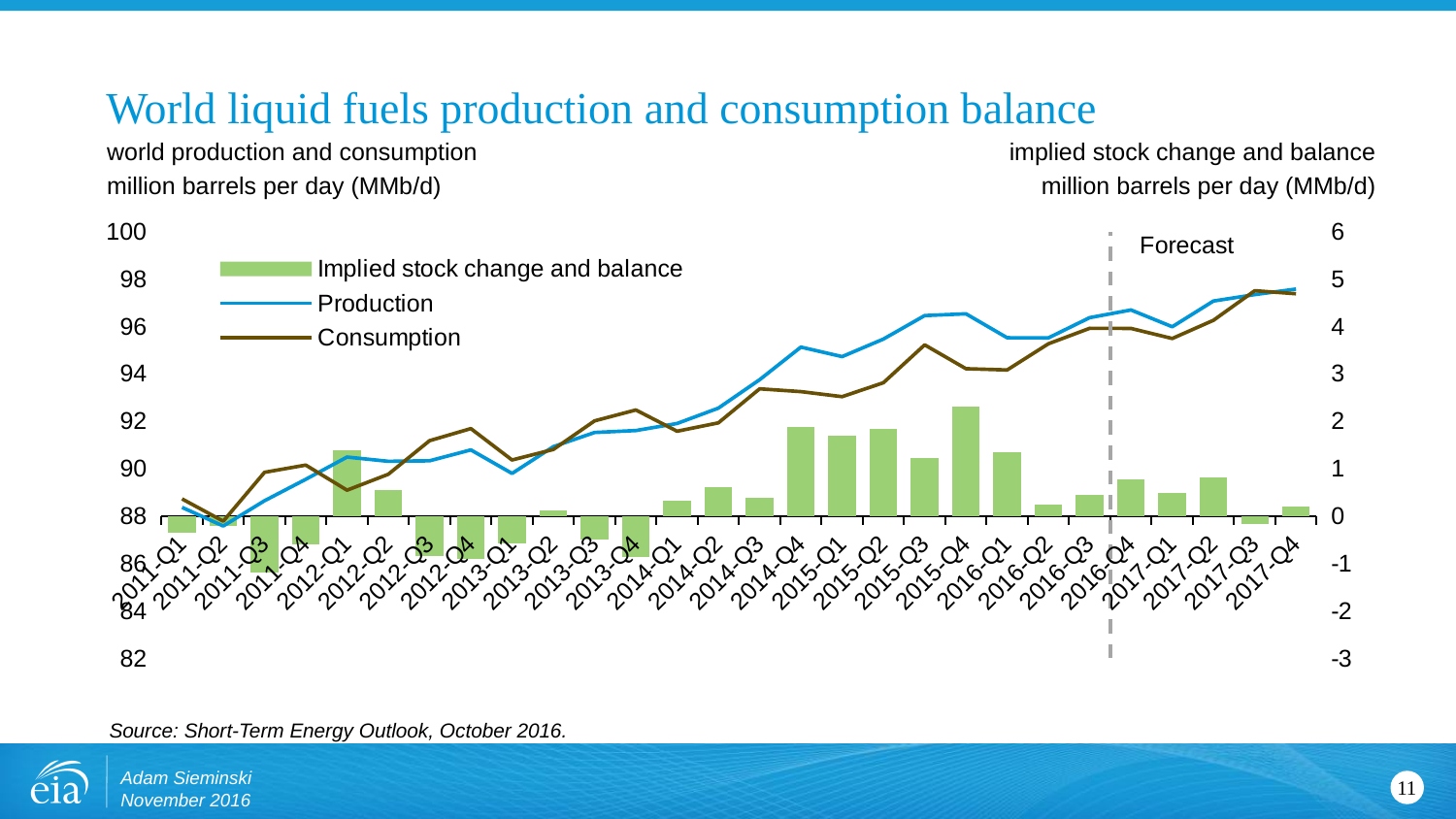
What is the title of the chart? World liquid fuels production and consumption balance Is the consumption value for 2011-Q1 greater or less than 90 MMb/d? less Is the production value for 2017-Q4 greater or less than 96 MMb/d? greater What kind of chart is this? Combined bar and line chart In 2015-Q4, which is larger, production or consumption? Production How many quarters are shown along the x axis? 28 Is the implied stock change and balance for 2015-Q4 greater or less than 2 on the right axis? greater In 2011-Q4, which is larger, production or consumption? Consumption In which quarter is the implied stock change and balance bar highest? 2015-Q4 Does the production line generally rise or fall from 2011-Q1 to 2017-Q4? Rise How many series does the chart legend list? 3